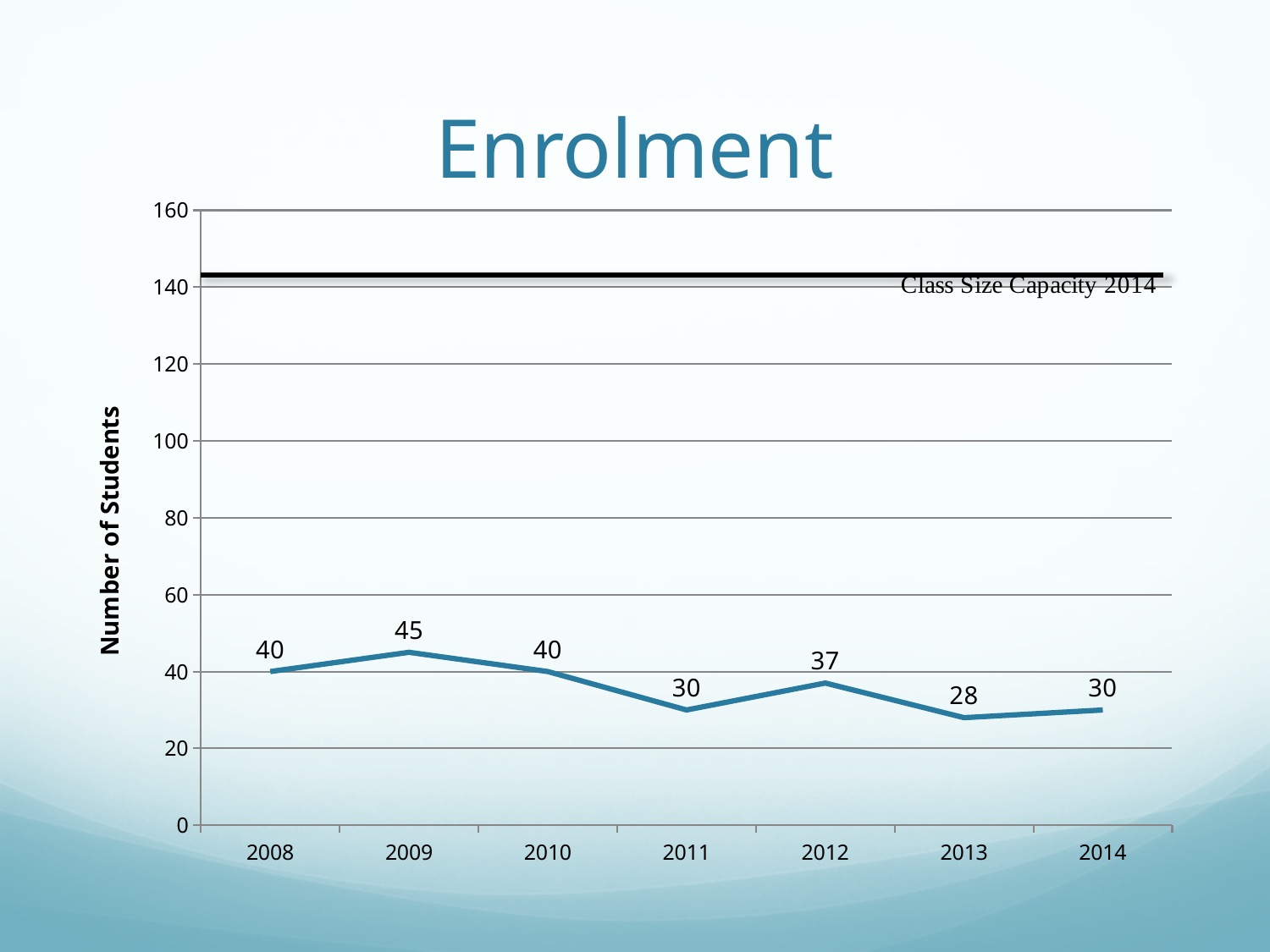
What is the difference between the enrolment in 2009 and the enrolment in 2013? 17 What kind of chart is shown on the slide? line chart Which year has the highest enrolment? 2009 How many years are plotted on the x axis? 7 Which year has the larger enrolment, 2011 or 2012? 2012 Is the Class Size Capacity 2014 line greater or less than 140? greater What is the enrolment value for 2013? 28 Which year has the lowest enrolment? 2013 What is the enrolment value for 2009? 45 What is the enrolment value for 2012? 37 Does enrolment rise or fall from 2010 to 2011? fall What is the label of the y axis? Number of Students